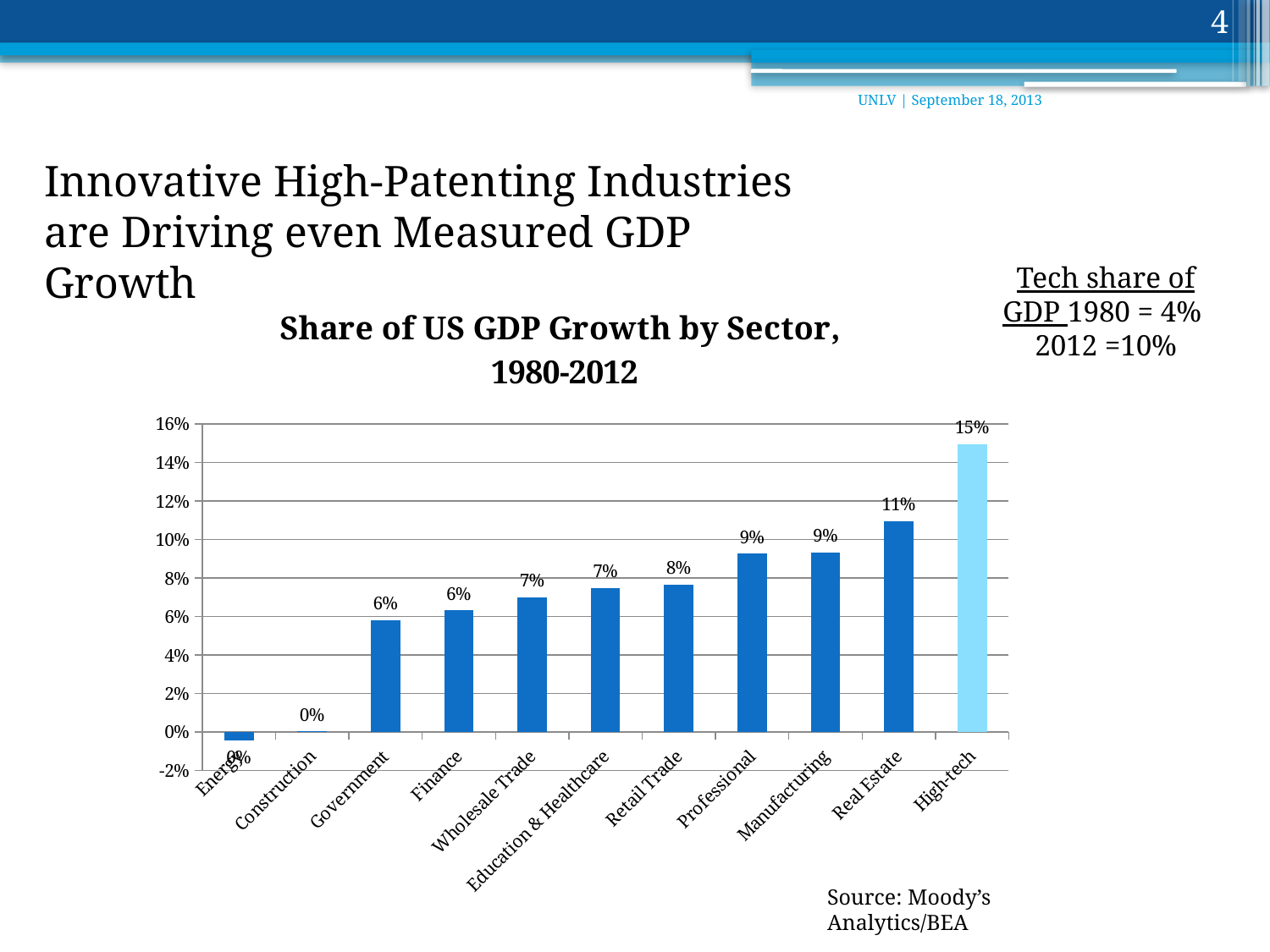
Do the values generally rise or fall from left to right across the sectors? Rise What is the share of US GDP growth for Retail Trade? 8% How many sectors are shown in the chart? 11 What is the share of US GDP growth for Real Estate? 11% Which sector has the lowest share of US GDP growth? Energy Is the value for Professional greater or less than 8%? greater What is the difference in percentage points between High-tech and Real Estate? 4 percentage points What is the share of US GDP growth for Government? 6% What is the share of US GDP growth for High-tech? 15% Which has a larger share of US GDP growth, Real Estate or Manufacturing? Real Estate Which sector has the highest share of US GDP growth? High-tech What type of chart is shown on the slide? Bar chart